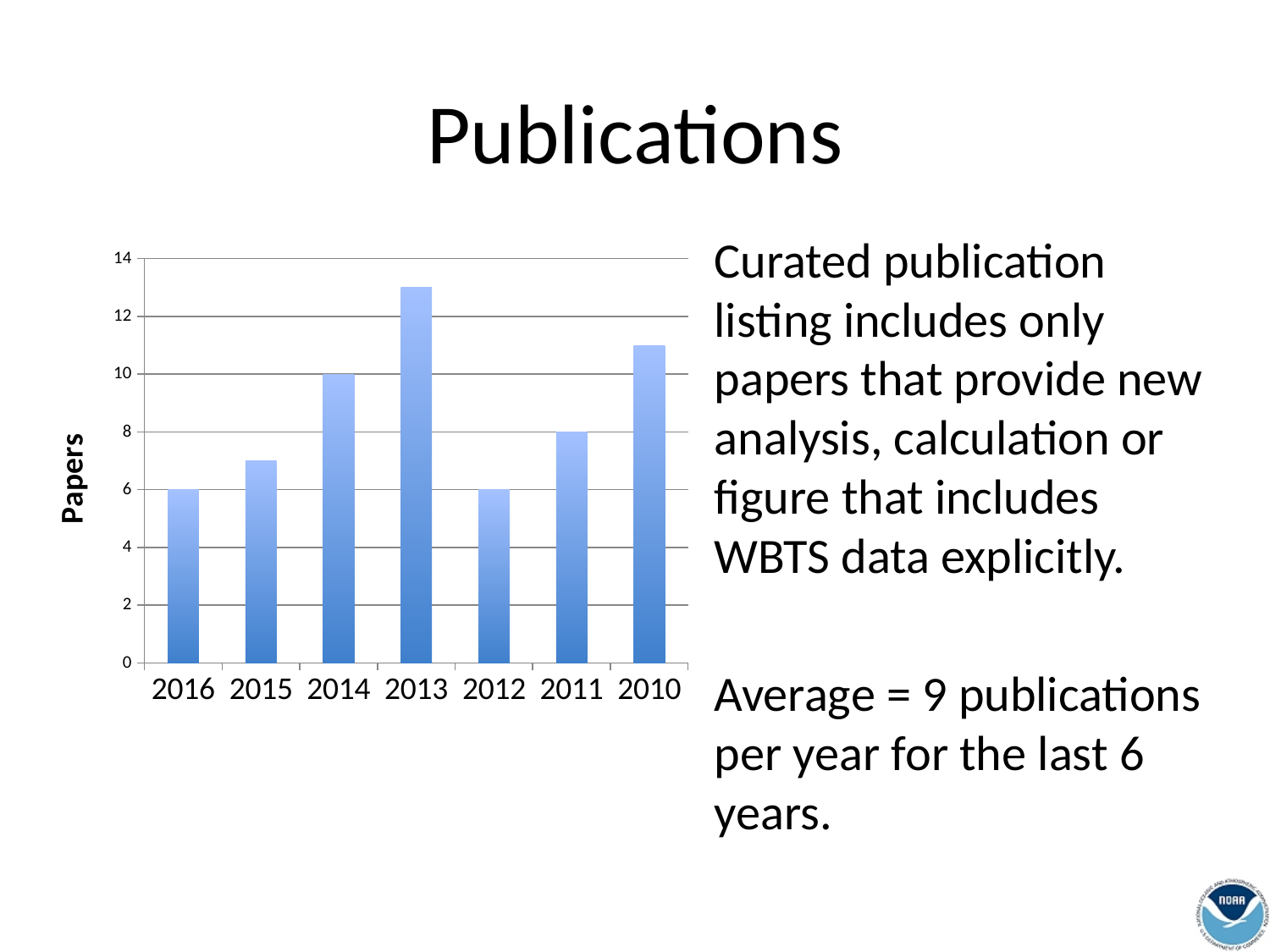
Which year has the highest number of papers? 2013 How many papers are shown for 2012? 6 How many papers are shown for 2011? 8 How many years are shown on the x axis of the chart? 7 Which year has more papers, 2013 or 2010? 2013 How many papers are shown for 2014? 10 What kind of chart is shown on the slide? bar chart How many papers are shown for 2016? 6 Is the value for 2010 greater or less than 10? greater What is the difference between the number of papers in 2014 and in 2011? 2 Is the value for 2015 greater or less than 8? less Is the value for 2013 greater or less than 12? greater